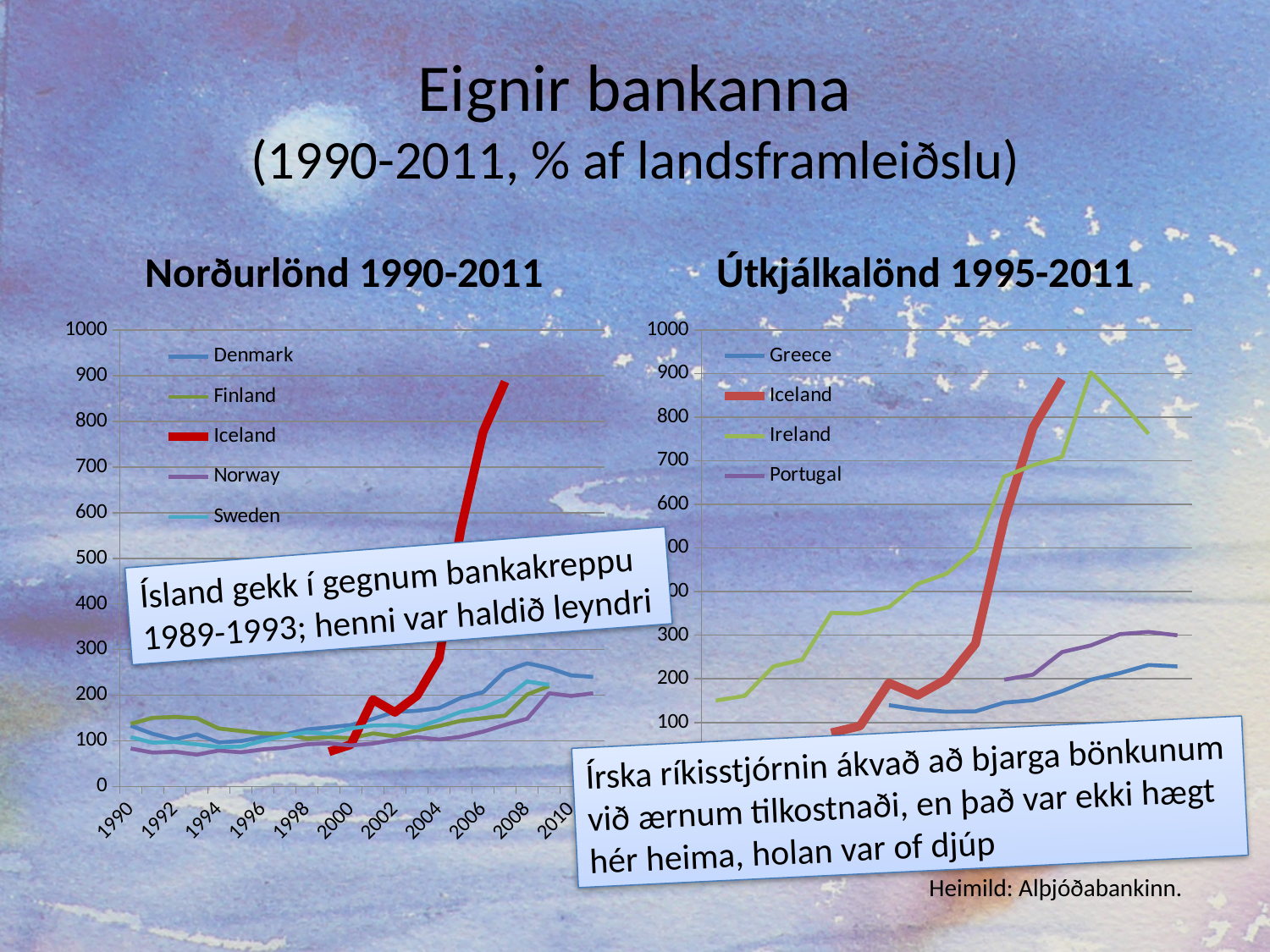
What kind of chart is the left chart titled 'Norðurlönd 1990-2011'? line chart Which series is drawn with a thick red line in both charts? Iceland In the right chart 'Útkjálkalönd 1995-2011', does the Ireland line rise or fall after reaching its peak? fall How many series does the legend of the right chart 'Útkjálkalönd 1995-2011' list? 4 In the left chart 'Norðurlönd 1990-2011', is the peak value for Denmark greater or less than 200? greater In the right chart 'Útkjálkalönd 1995-2011', is the peak value for Greece greater or less than 300? less In the left chart 'Norðurlönd 1990-2011', is the peak value for Iceland greater or less than 800? greater In the right chart 'Útkjálkalönd 1995-2011', which series stays lowest throughout the period? Greece In the left chart 'Norðurlönd 1990-2011', which series reaches the highest value? Iceland How many series does the legend of the left chart 'Norðurlönd 1990-2011' list? 5